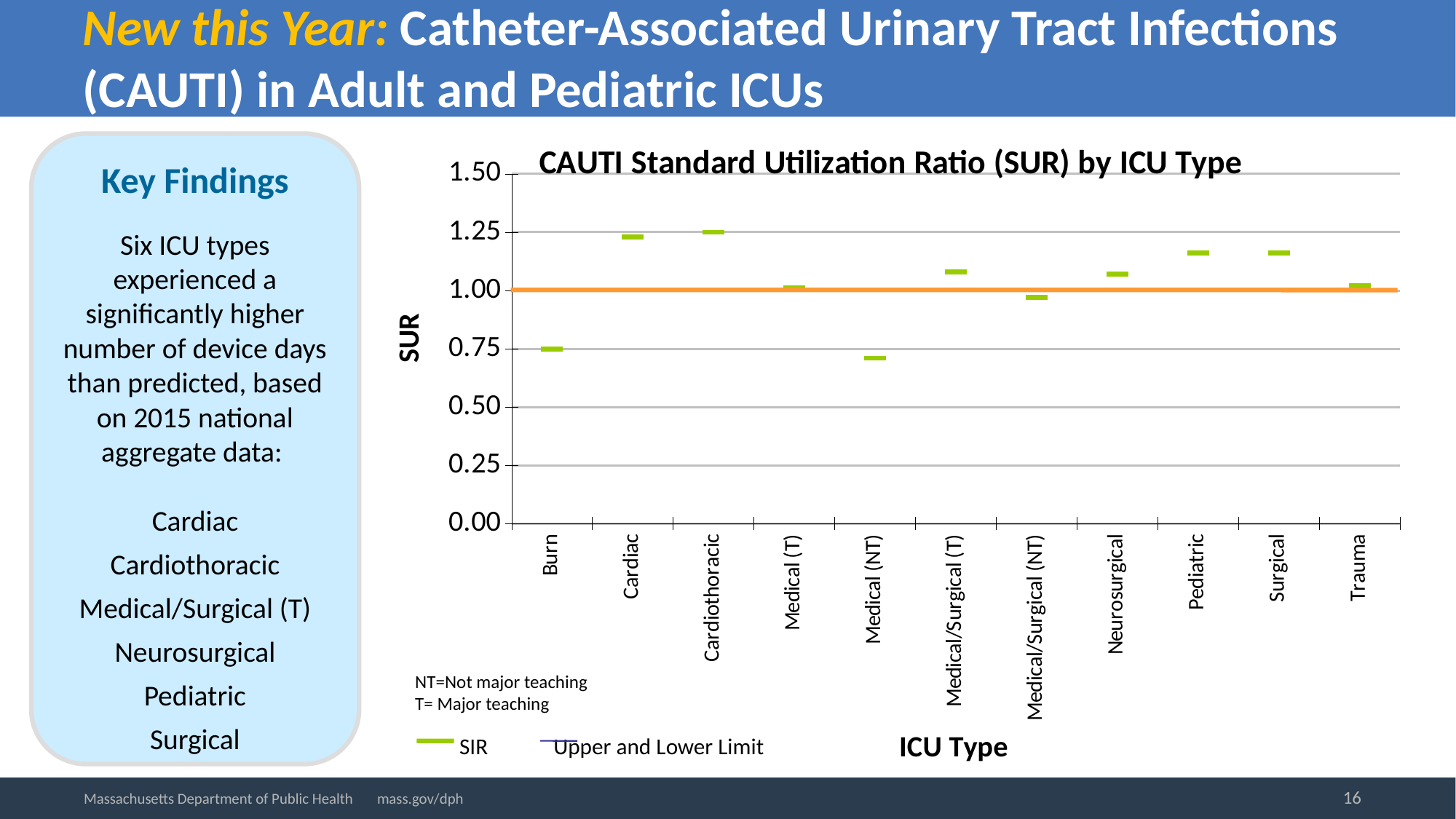
Is the SUR for Burn greater or less than 1.00? less How many entries does the legend of the CAUTI SUR by ICU Type chart list? 2 Is the SUR for Medical/Surgical (NT) greater or less than 1.00? less How many ICU types are shown on the x axis of the CAUTI Standard Utilization Ratio (SUR) by ICU Type chart? 11 Which has a higher SUR, Medical/Surgical (T) or Medical/Surgical (NT)? Medical/Surgical (T) Which ICU type has the lowest SUR in the CAUTI SUR by ICU Type chart? Medical (NT) What is the title of the y axis on the CAUTI SUR by ICU Type chart? SUR Which has a higher SUR, Cardiac or Burn? Cardiac Is the SUR for Medical (NT) greater or less than 0.75? less At what SUR value is the horizontal orange reference line drawn on the chart? 1.00